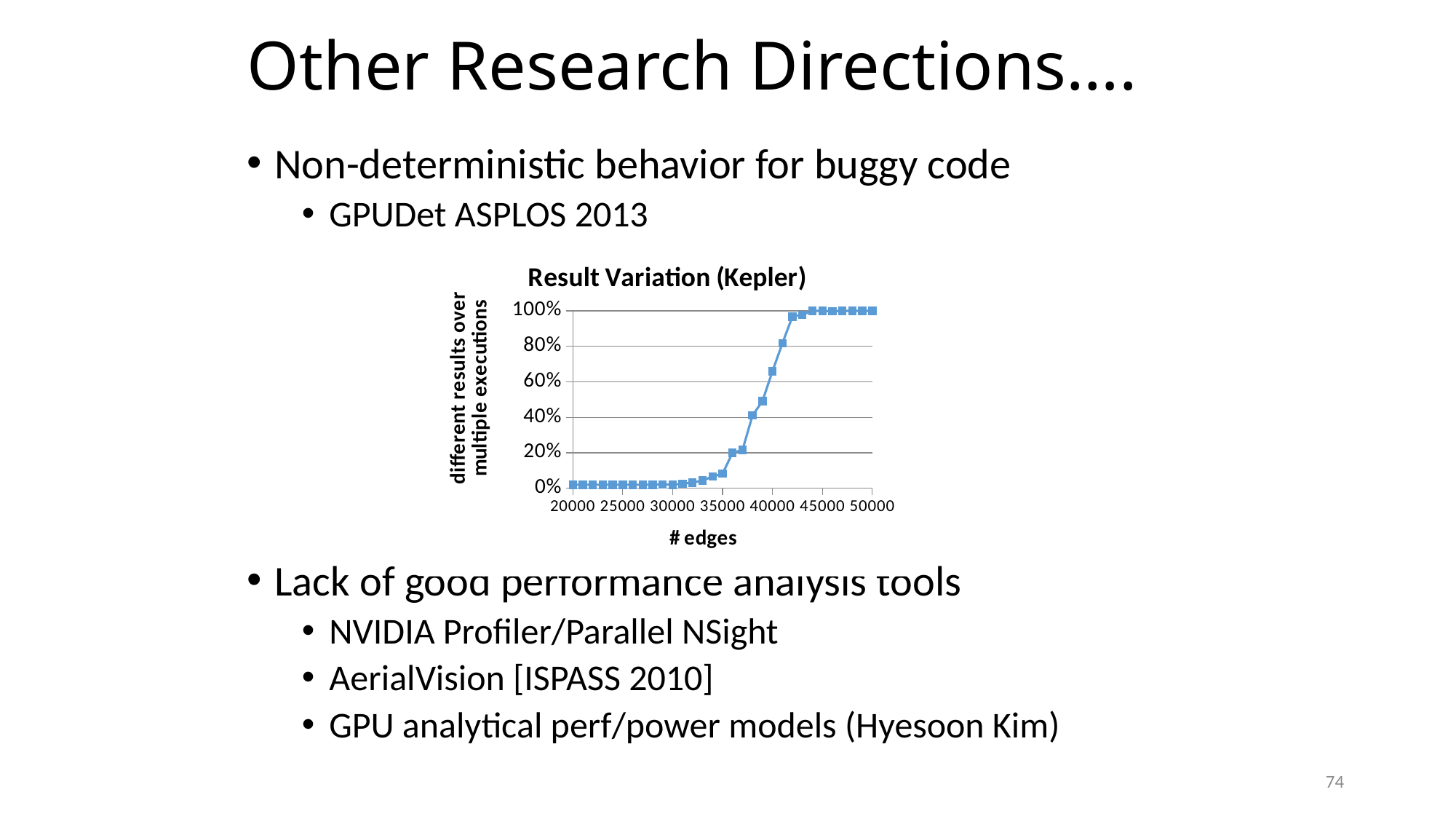
Is the value at 45000 edges greater or less than 80%? greater Is the value at 35000 edges greater or less than 20%? less Is the value at 40000 edges greater or less than 40%? greater Which has the larger value, 30000 edges or 40000 edges? 40000 edges What is the label of the x axis of the chart? # edges Do the values in the chart rise or fall as the number of edges increases? rise What is the title of the chart? Result Variation (Kepler) What is the highest value reached by the line in the chart? 100% What kind of chart is shown on the slide? line chart What is the value plotted at 50000 edges? 100%